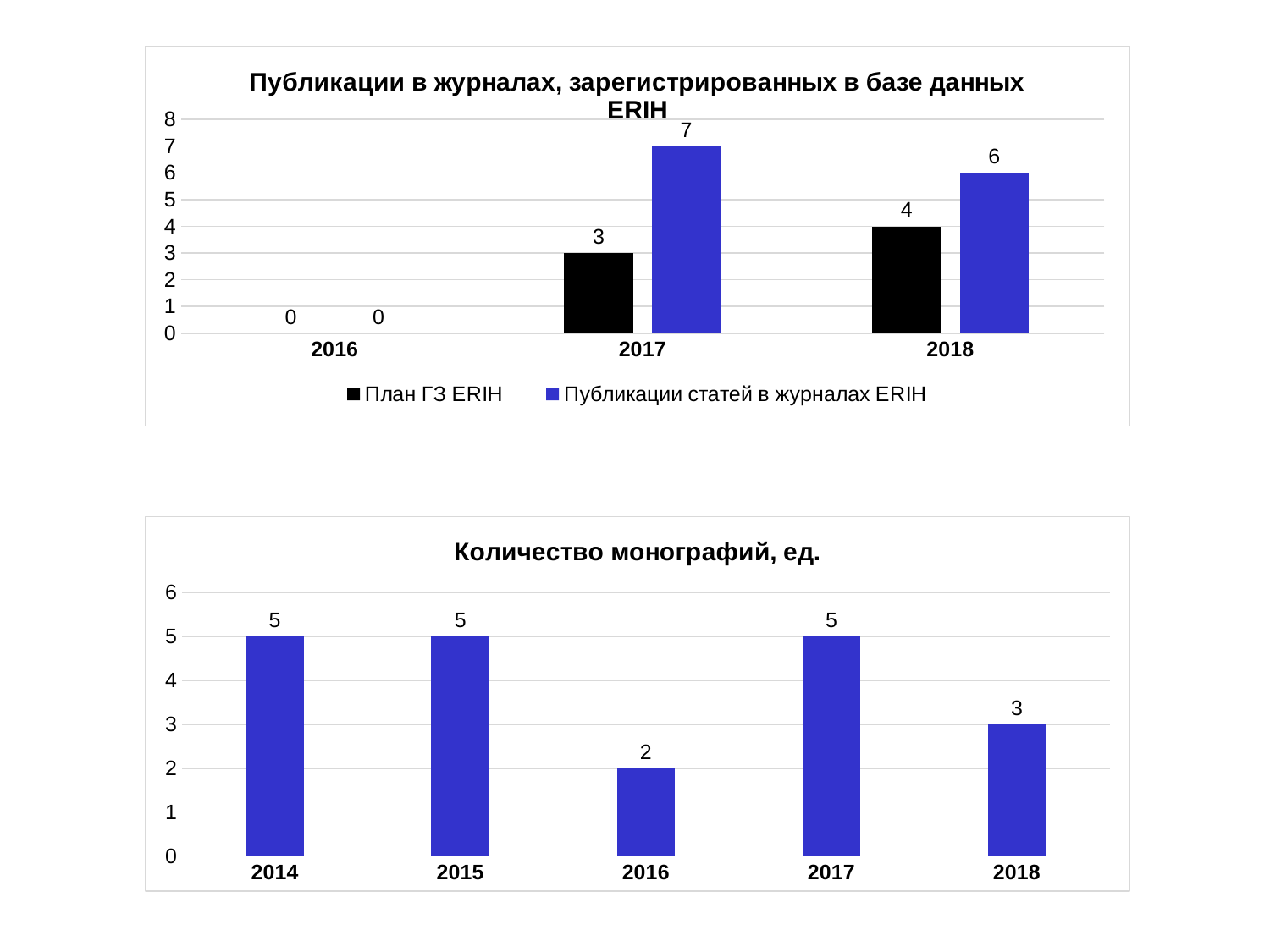
In the top chart 'Публикации в журналах, зарегистрированных в базе данных ERIH', what is the value of 'План ГЗ ERIH' for 2016? 0 In the bottom chart 'Количество монографий, ед.', how many years are shown on the x axis? 5 In the bottom chart 'Количество монографий, ед.', what is the difference between the values for 2017 and 2018? 2 In the bottom chart 'Количество монографий, ед.', which is larger, the value for 2015 or the value for 2018? 2015 In the top chart 'Публикации в журналах, зарегистрированных в базе данных ERIH', what is the difference between 'Публикации статей в журналах ERIH' and 'План ГЗ ERIH' in 2017? 4 In the top chart 'Публикации в журналах, зарегистрированных в базе данных ERIH', which year has the highest value for 'Публикации статей в журналах ERIH'? 2017 In the bottom chart 'Количество монографий, ед.', which year has the lowest value? 2016 In the top chart 'Публикации в журналах, зарегистрированных в базе данных ERIH', how many series does the legend list? 2 In the top chart 'Публикации в журналах, зарегистрированных в базе данных ERIH', what is the value of 'План ГЗ ERIH' for 2018? 4 In the top chart 'Публикации в журналах, зарегистрированных в базе данных ERIH', what is the value of 'Публикации статей в журналах ERIH' for 2017? 7 In the bottom chart 'Количество монографий, ед.', what is the value for 2016? 2 What type of chart is the bottom chart 'Количество монографий, ед.'? Bar chart